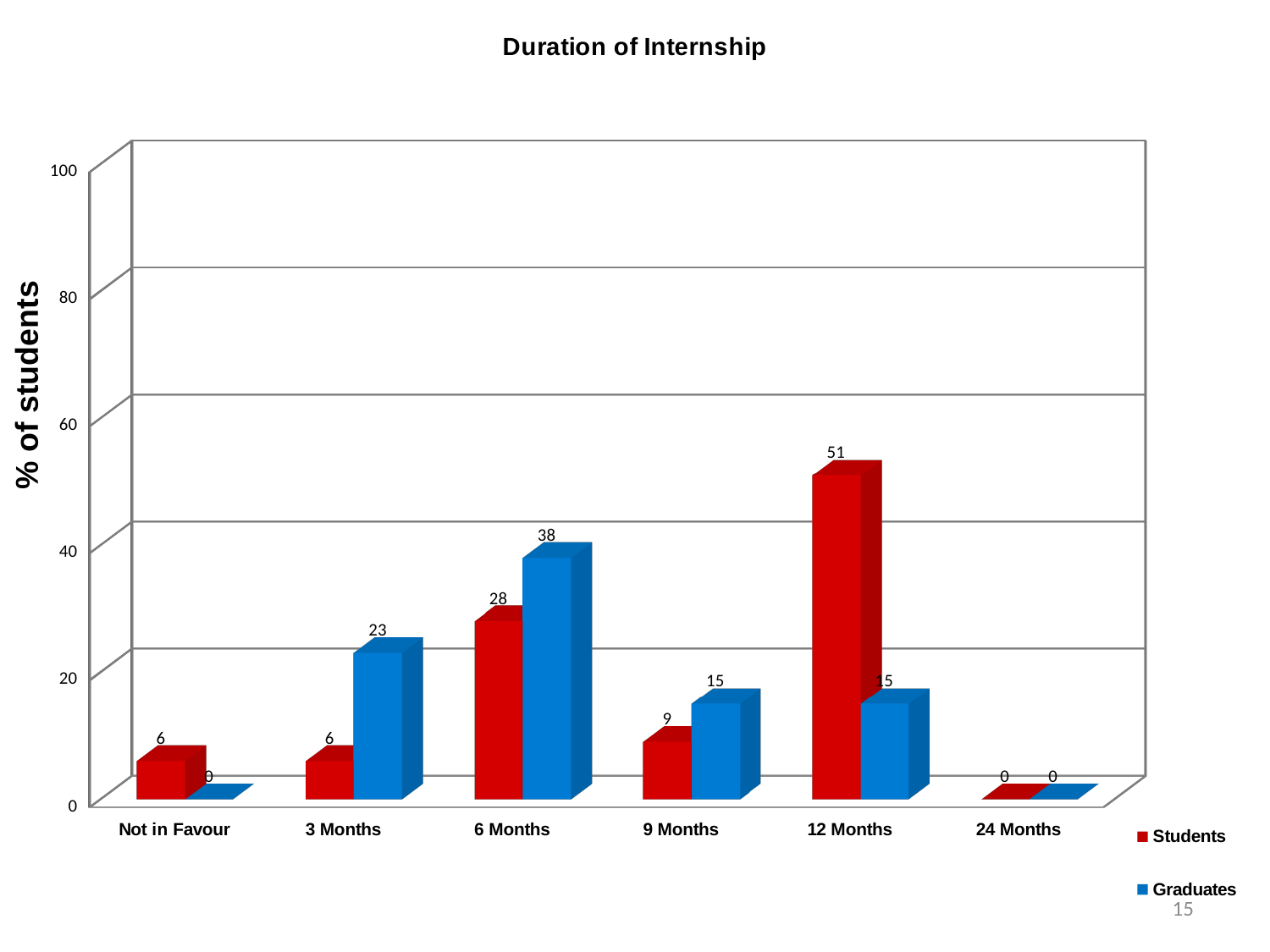
How many series does the legend list? 2 What is the value for Students at 12 Months? 51 What is the value for Graduates at 6 Months? 38 What kind of chart is shown on the slide? Bar chart What is the value for Graduates at 3 Months? 23 How many categories are shown on the x axis? 6 Which category has the highest value for Graduates? 6 Months What is the difference between the Students and Graduates values at 12 Months? 36 Which category has the highest value for Students? 12 Months At 9 Months, which series has the larger value, Students or Graduates? Graduates What is the difference between the Graduates and Students values at 6 Months? 10 What is the title of the chart? Duration of Internship